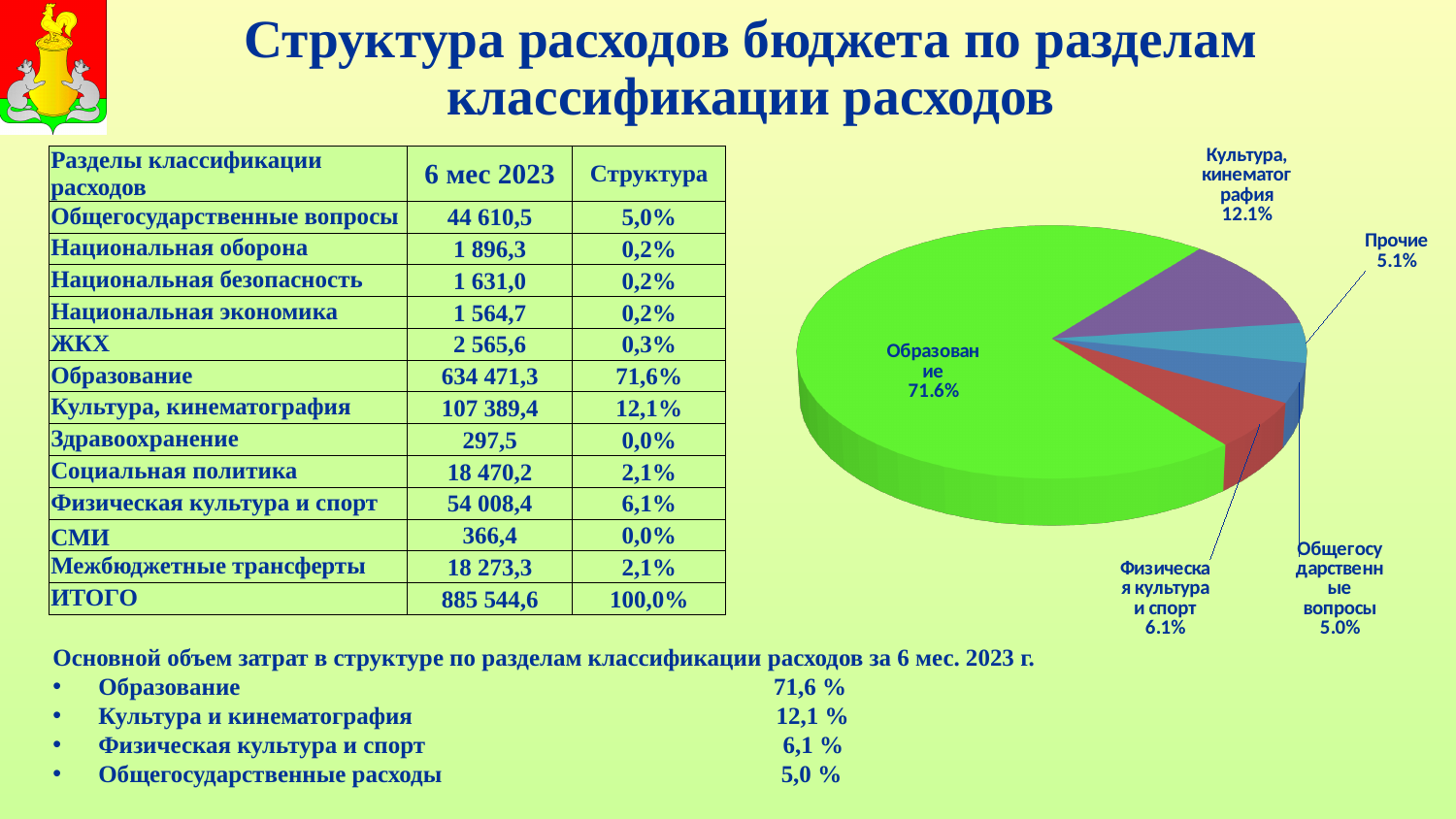
What is the value shown for Физическая культура и спорт in the pie chart? 6.1% Which slice of the pie chart is the smallest? Общегосударственные вопросы What is the difference between the Образование and Культура, кинематография shares in the pie chart? 59.5% What is the value shown for Культура, кинематография in the pie chart? 12.1% What colour is the Образование slice in the pie chart? green What share of the pie chart does Образование have? 71.6% How many slices does the pie chart have? 5 What is the value shown for Общегосударственные вопросы in the pie chart? 5.0% What is the value shown for Прочие in the pie chart? 5.1% Which slice of the pie chart is the largest? Образование What kind of chart is shown on the slide? pie chart Which is larger in the pie chart, Физическая культура и спорт or Прочие? Физическая культура и спорт